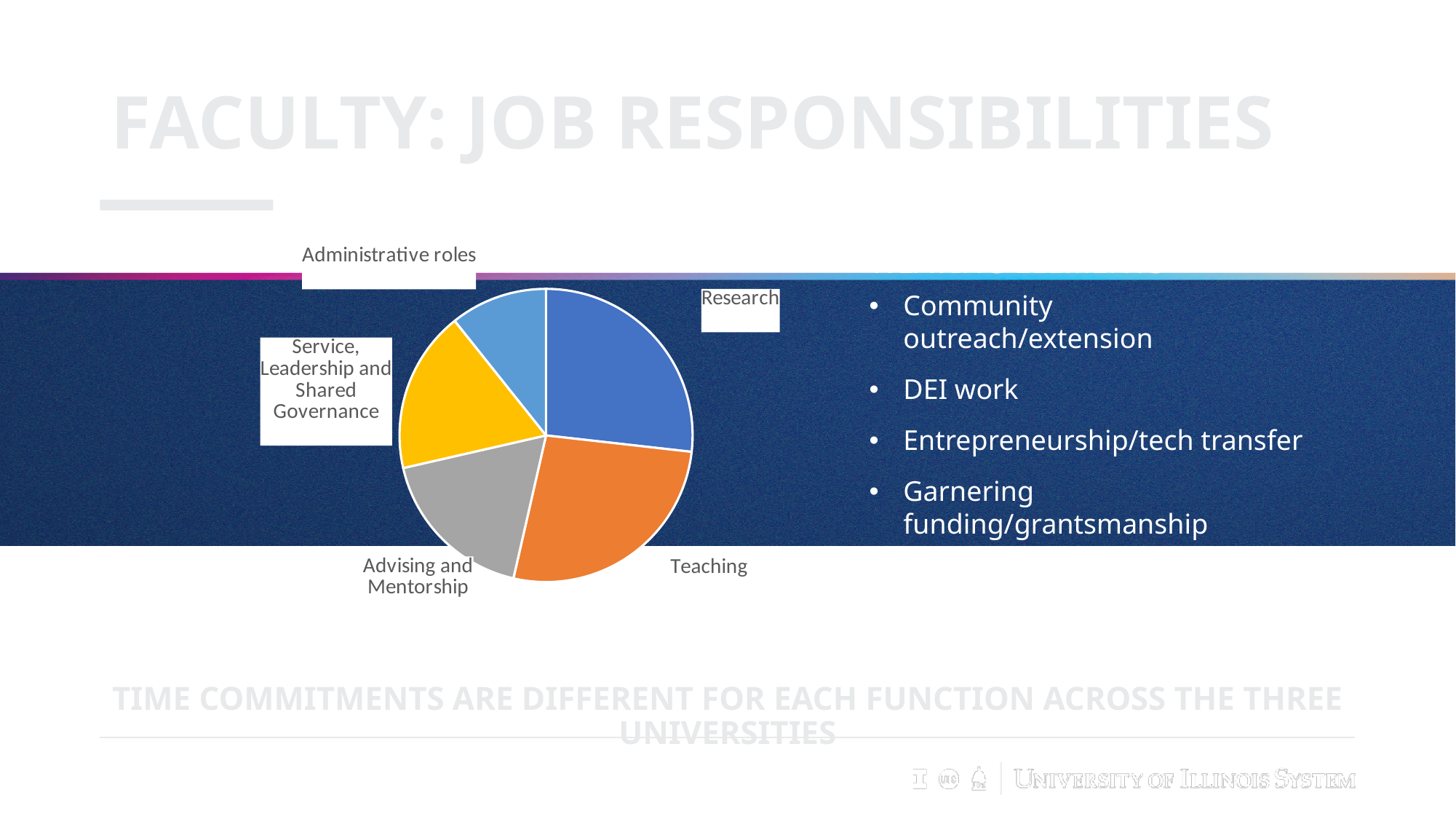
What colour is the Teaching slice of the pie chart? Orange How many slices does the pie chart have? 5 Which slice of the pie chart is the smallest? Administrative roles Which slice is larger, Teaching or Advising and Mentorship? Teaching Which slice is larger, Teaching or Service, Leadership and Shared Governance? Teaching Which slice of the pie chart is coloured yellow? Service, Leadership and Shared Governance Which slice is larger, Service, Leadership and Shared Governance or Administrative roles? Service, Leadership and Shared Governance What kind of chart is shown on the slide? Pie chart